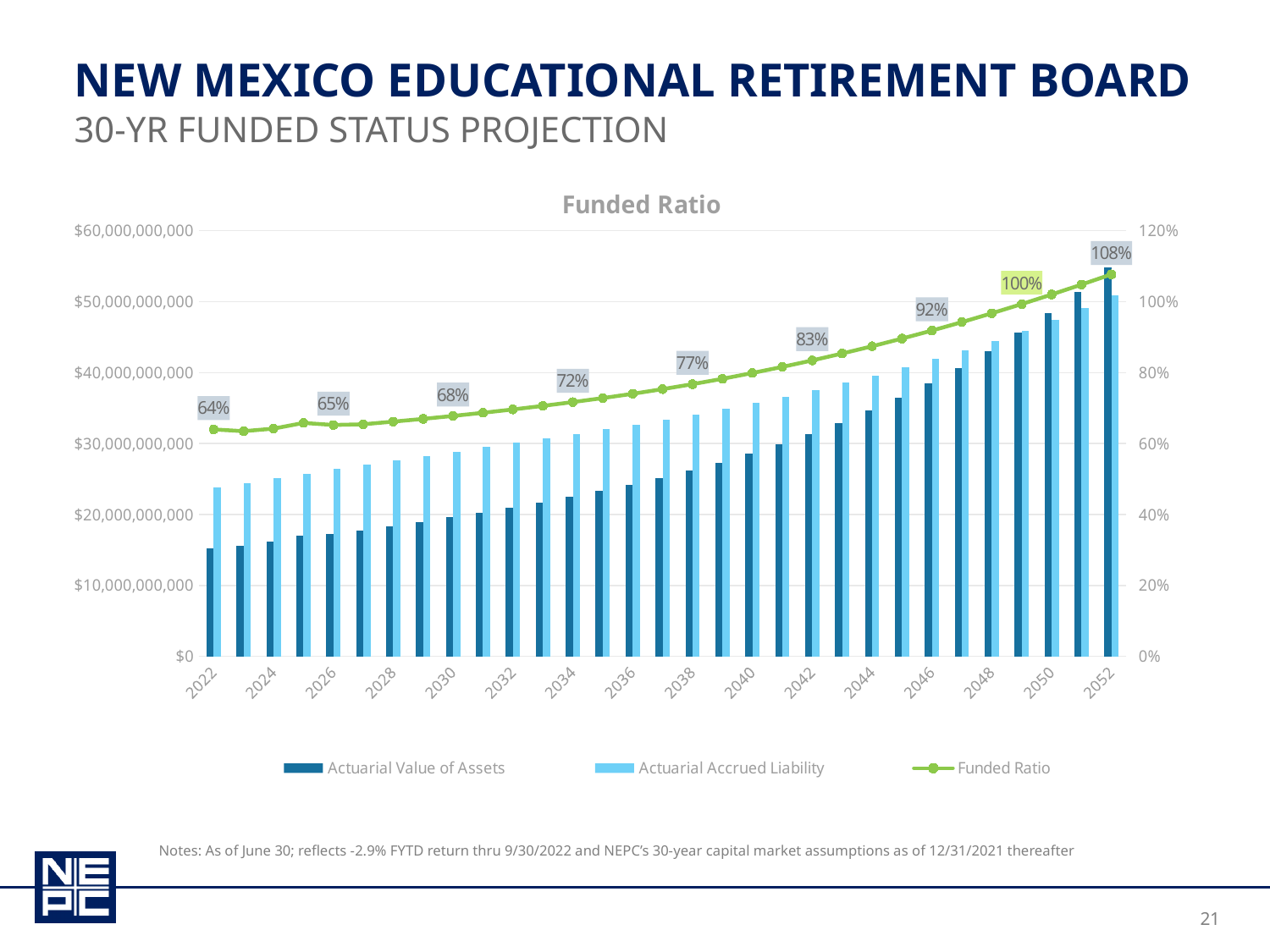
Does the Funded Ratio line rise or fall from 2022 to 2052? It rises What is the Funded Ratio labelled for 2038? 77% What kind of chart is this? A bar chart with a line series (combo chart) What is the Funded Ratio shown for 2022? 64% Is the Actuarial Value of Assets in 2022 greater or less than $20,000,000,000? less What is the difference between the Funded Ratio labels for 2046 and 2042? 9 percentage points What is the Funded Ratio labelled for 2042? 83% How many series does the legend list? 3 What is the Funded Ratio shown for 2052? 108% By how many percentage points does the labelled Funded Ratio in 2052 exceed the one in 2022? 44 percentage points Is the Actuarial Accrued Liability in 2022 greater or less than $20,000,000,000? greater In 2022, which is larger: the Actuarial Value of Assets or the Actuarial Accrued Liability? Actuarial Accrued Liability